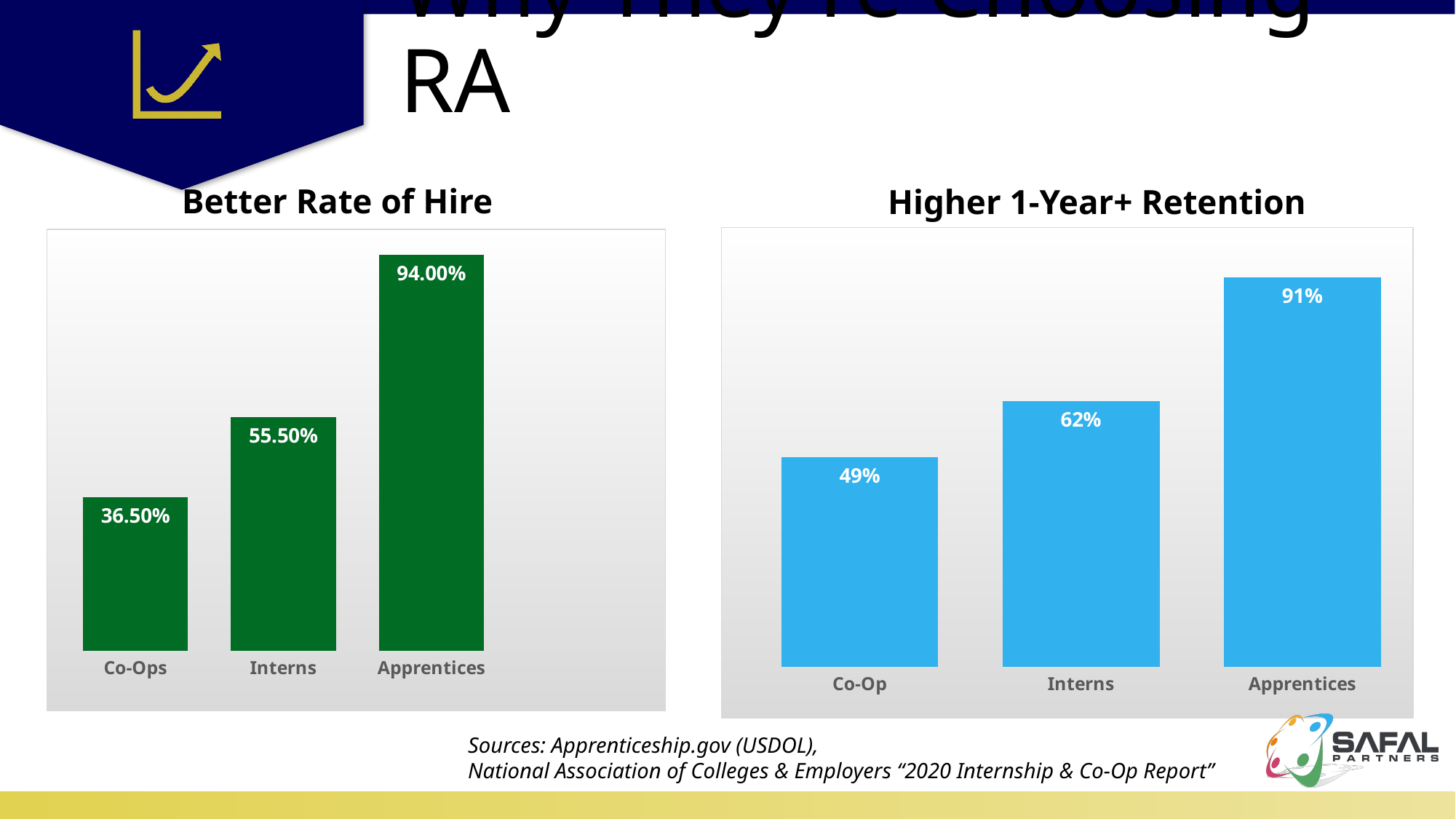
In the 'Higher 1-Year+ Retention' chart, what is the value for Co-Op? 49% In the 'Higher 1-Year+ Retention' chart, what is the difference between the values for Apprentices and Co-Op? 42% In the 'Better Rate of Hire' chart, what is the difference between the values for Apprentices and Interns? 38.50% In the 'Higher 1-Year+ Retention' chart, do the values rise or fall from left to right? Rise In the 'Higher 1-Year+ Retention' chart, which category has the lowest value? Co-Op In the 'Higher 1-Year+ Retention' chart, what is the value for Interns? 62% In the 'Better Rate of Hire' chart, what is the value for Co-Ops? 36.50% In the 'Better Rate of Hire' chart, which category has the highest value? Apprentices In the 'Better Rate of Hire' chart, which is larger, the value for Interns or the value for Co-Ops? Interns How many categories are shown in the 'Higher 1-Year+ Retention' chart? 3 In the 'Better Rate of Hire' chart, what is the value for Apprentices? 94.00% What kind of chart is the 'Better Rate of Hire' chart? Bar chart